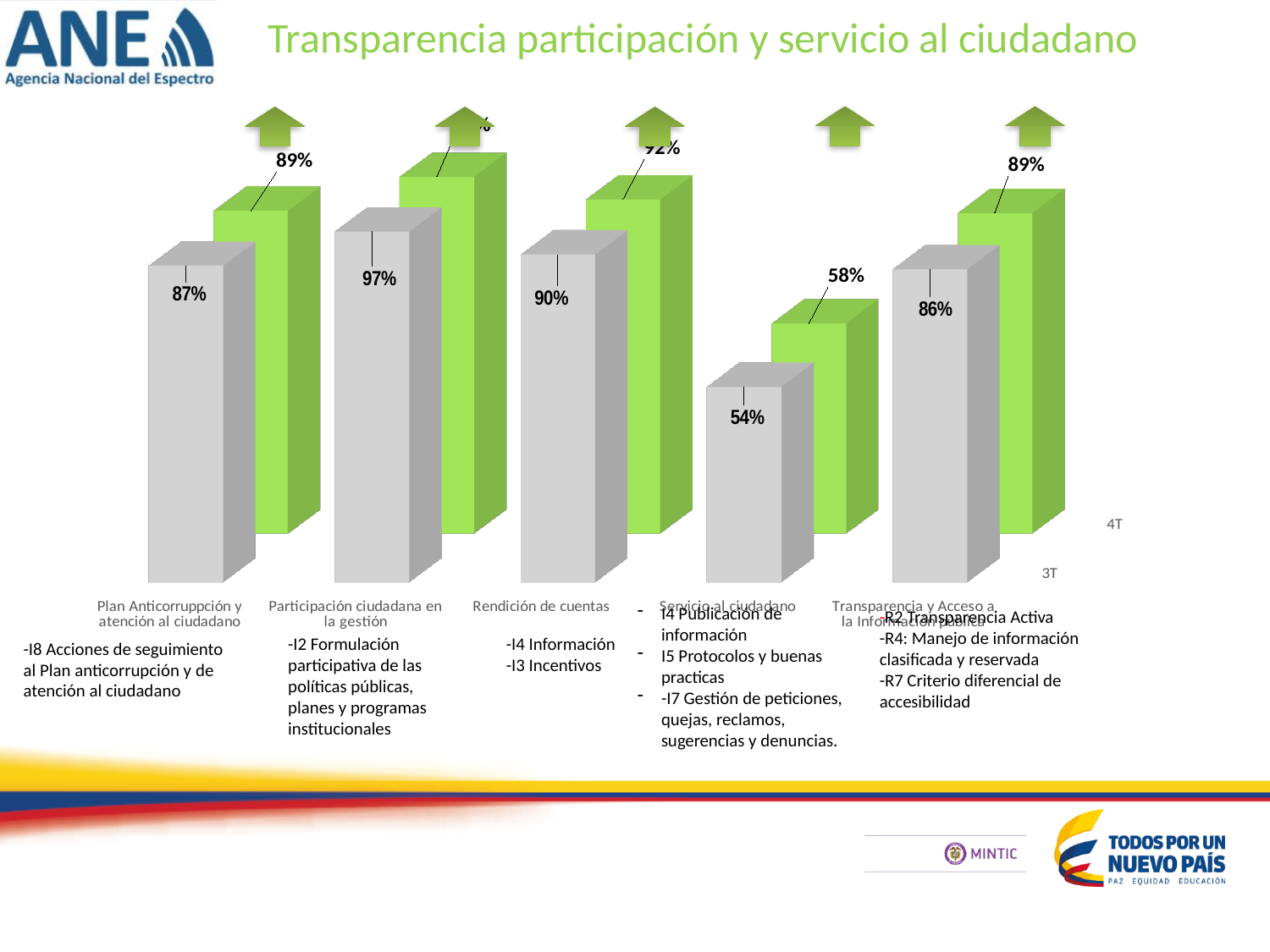
Which category has the lowest 3T value? Servicio al ciudadano What is the 3T value for Servicio al ciudadano? 54% What is the 3T value for Transparencia y Acceso a la Información pública? 86% What is the difference between the 4T and 3T values for Servicio al ciudadano? 4% Which category has the highest 3T value? Participación ciudadana en la gestión What is the 3T value for Participación ciudadana en la gestión? 97% What is the 3T value for Plan Anticorrupción y atención al ciudadano? 87% What is the 3T value for Rendición de cuentas? 90% What kind of chart is shown on the slide? Bar chart How many categories are shown on the chart? 5 What is the 4T value for Plan Anticorrupción y atención al ciudadano? 89% What is the 4T value for Servicio al ciudadano? 58%